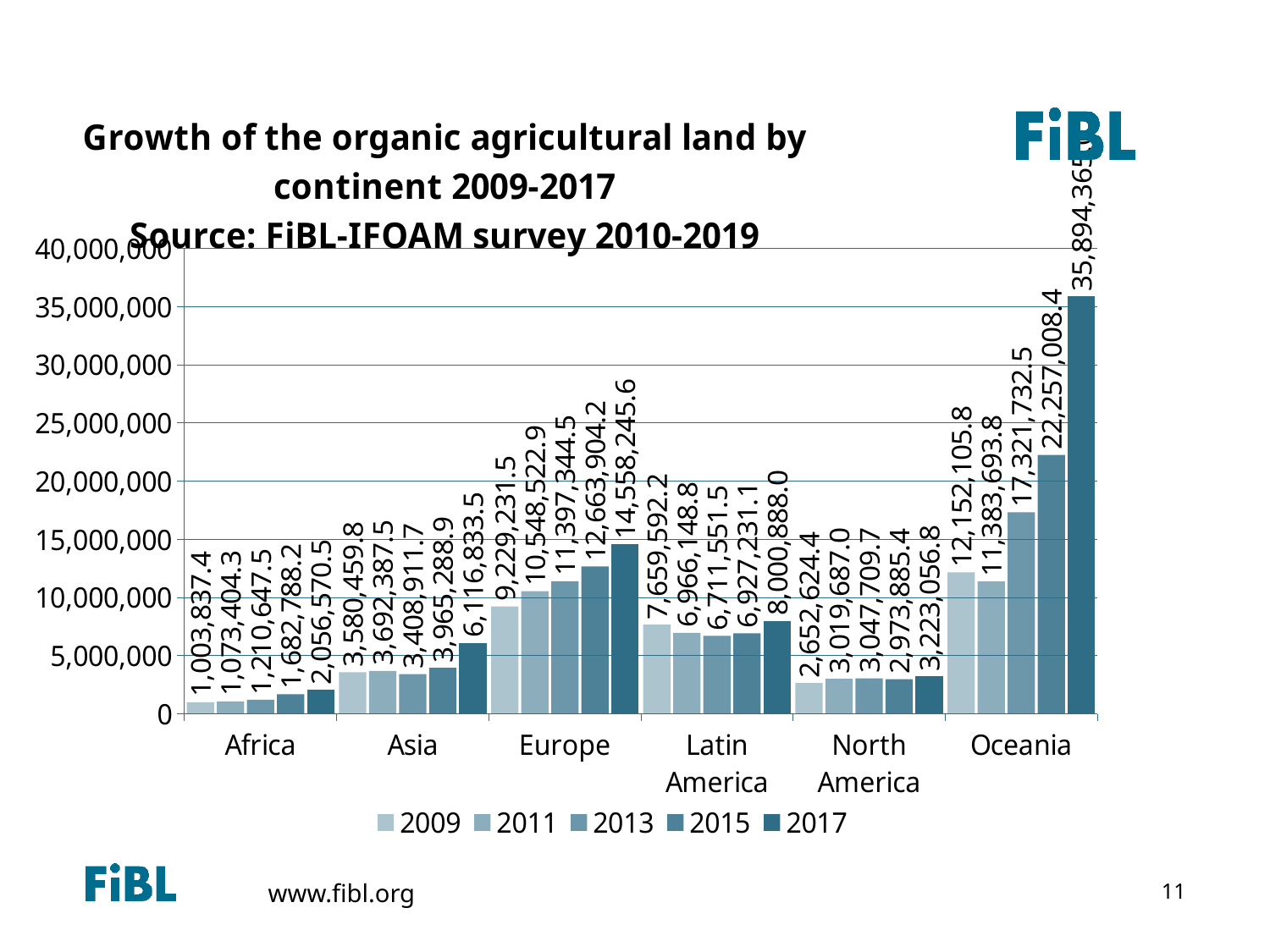
How many continents are shown on the x axis? 6 How many series does the legend list? 5 What is the value for Oceania in 2015? 22,257,008.4 What is the value for Latin America in 2017? 8,000,888.0 Which continent has the highest value in 2009? Oceania Do the values for Africa rise or fall from 2009 to 2017? rise What is the value for Europe in 2017? 14,558,245.6 What is the value for Africa in 2009? 1,003,837.4 What type of chart is shown on the slide? bar chart Which is larger: Asia in 2017 or Latin America in 2017? Latin America in 2017 Which continent has the lowest value in 2017? Africa What is the difference between Europe's 2017 and 2009 values? 5,329,014.1